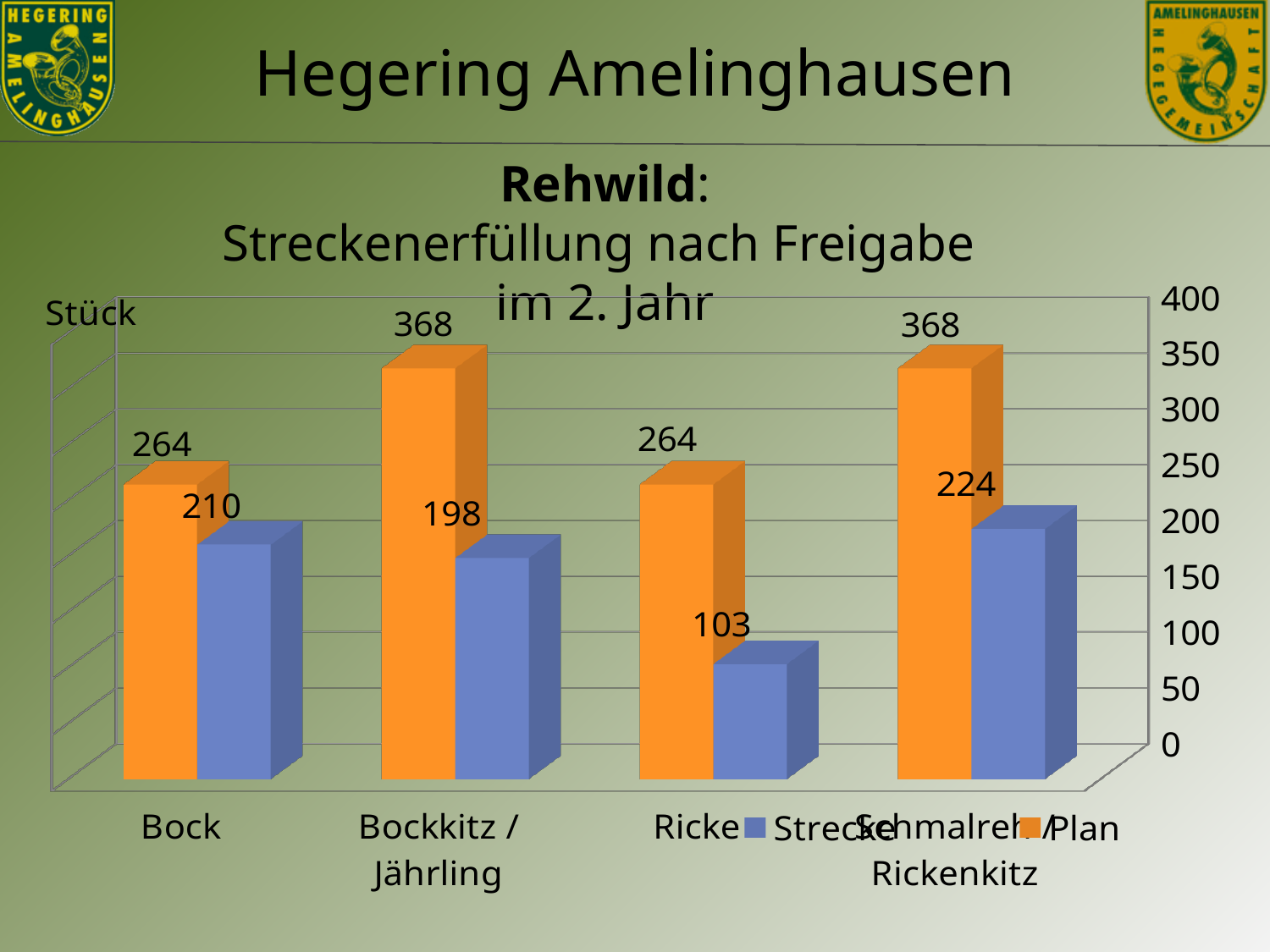
What is the difference between the Plan and Strecke values for Bock? 54 What is the Plan value for Bockkitz / Jährling? 368 How many series does the legend list? 2 Which category has the highest Strecke value? Schmalreh / Rickenkitz What is the difference between the Plan and Strecke values for Ricke? 161 What is the Plan value for Bock? 264 What kind of chart is shown on the slide? Bar chart What is the Strecke value for Ricke? 103 How many categories are shown on the x axis? 4 Which category has the lowest Strecke value? Ricke Which is larger, the Strecke value for Bock or the Strecke value for Bockkitz / Jährling? Bock What is the Strecke value for Schmalreh / Rickenkitz? 224